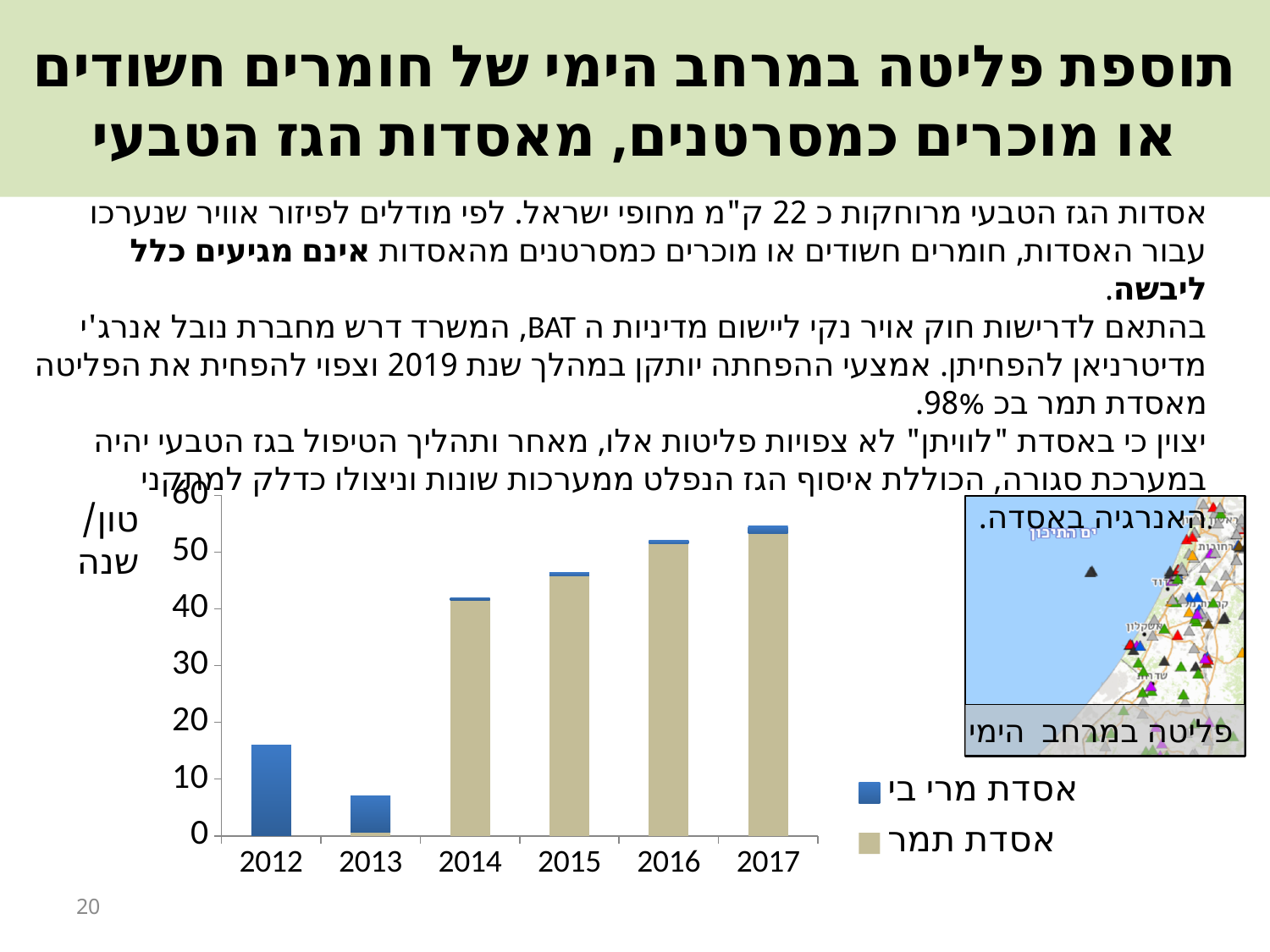
Which year has the tallest stacked bar in the chart? 2017 Is the total stacked value for 2013 greater or less than 10? less Which year has the shortest stacked bar in the chart? 2013 Do the stacked bar totals rise or fall from 2014 to 2017? rise Is the total stacked value for 2016 greater or less than 50? greater What kind of chart is shown on the slide? bar chart Which series is shown in blue in the chart legend? אסדת מרי בי Which year has a larger stacked bar, 2012 or 2015? 2015 How many series does the chart legend list? 2 Is the total stacked value for 2014 greater or less than 40? greater How many years are shown on the x axis of the chart? 6